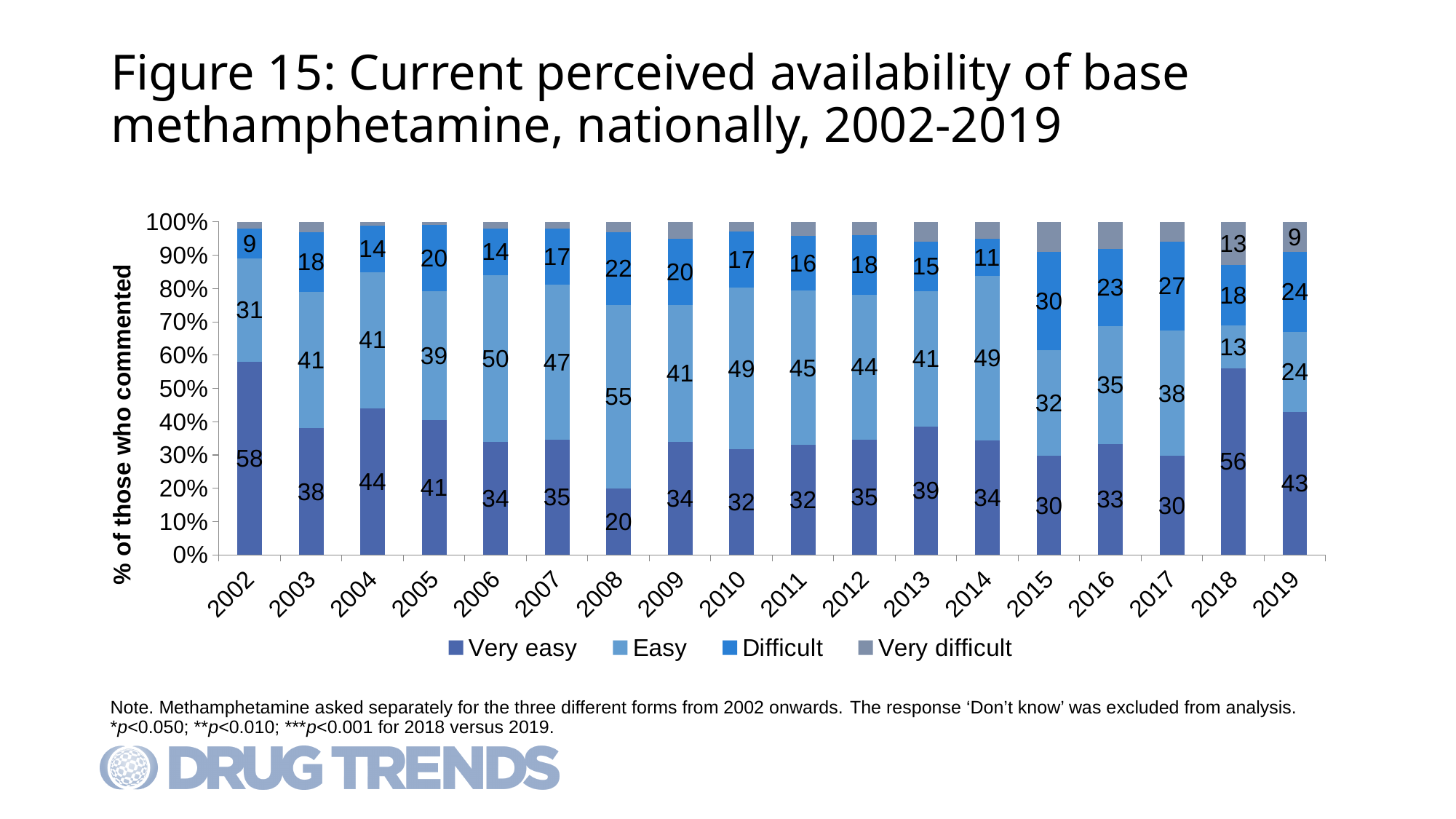
What is the 'Difficult' value for 2015? 30 In which year is the 'Very easy' value lowest? 2008 In which year is the 'Easy' value lowest? 2018 What is the difference between the 'Very easy' values for 2018 and 2019? 13 In which year is the 'Very easy' value highest? 2002 Which year has the larger 'Difficult' value, 2014 or 2015? 2015 What is the 'Very difficult' value shown for 2018? 13 What percentage of respondents rated base methamphetamine as 'Very easy' to obtain in 2002? 58 How many years are shown on the x axis? 18 What is the 'Easy' value for 2008? 55 Is the 'Very easy' segment for 2002 greater or less than 50%? greater How many series does the legend list? 4